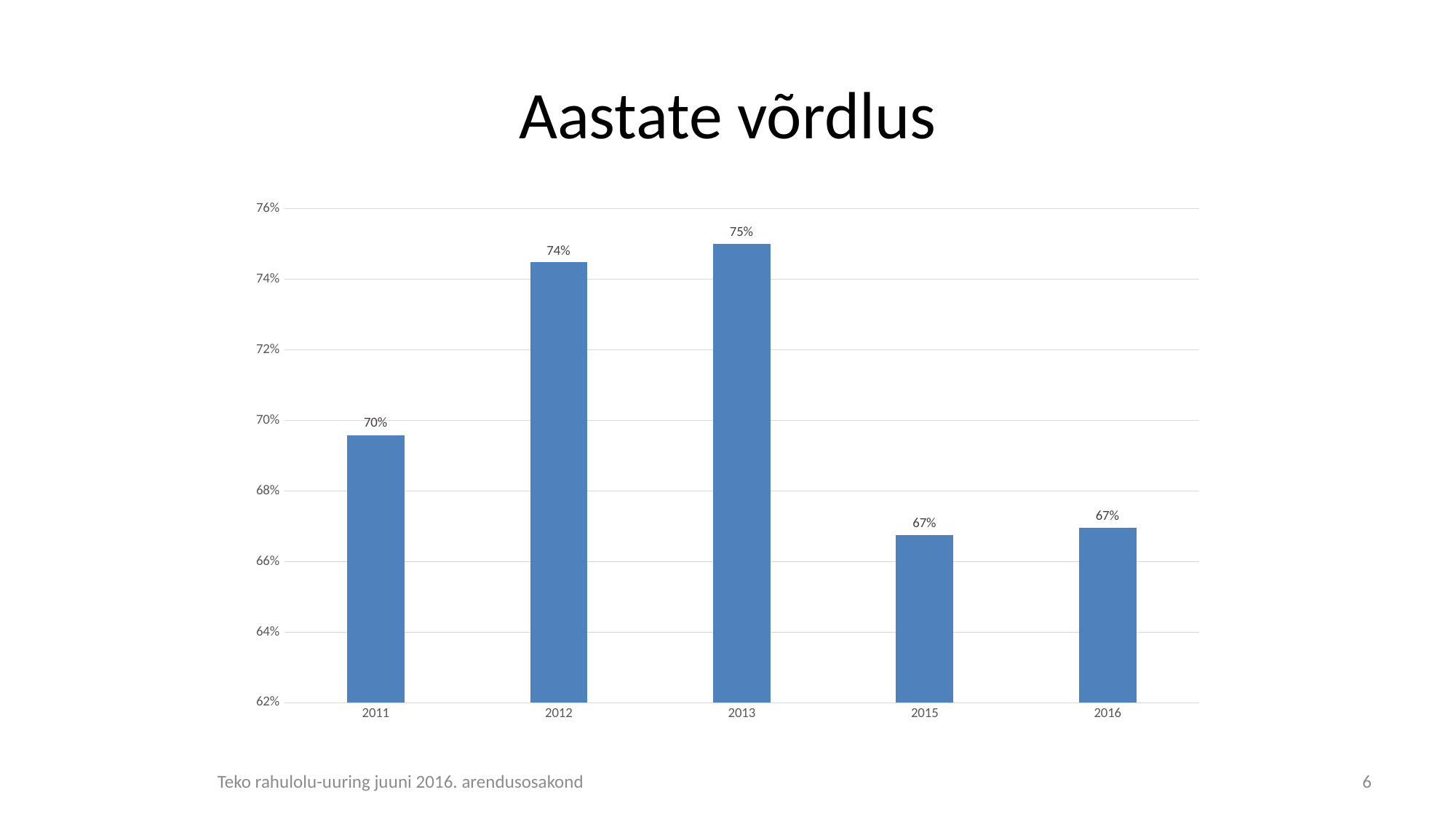
Is the value for 2013 greater or less than 74%? greater Which year has the highest value? 2013 What is the difference between the values for 2013 and 2011? 5% What type of chart is shown on the slide? bar chart What is the value for 2013? 75% What is the value for 2012? 74% What is the value for 2015? 67% Do the values rise or fall from 2013 to 2016? fall Which is larger, the value for 2012 or the value for 2015? 2012 What is the title of the chart? Aastate võrdlus How many years are shown on the x axis? 5 What is the value for 2011? 70%